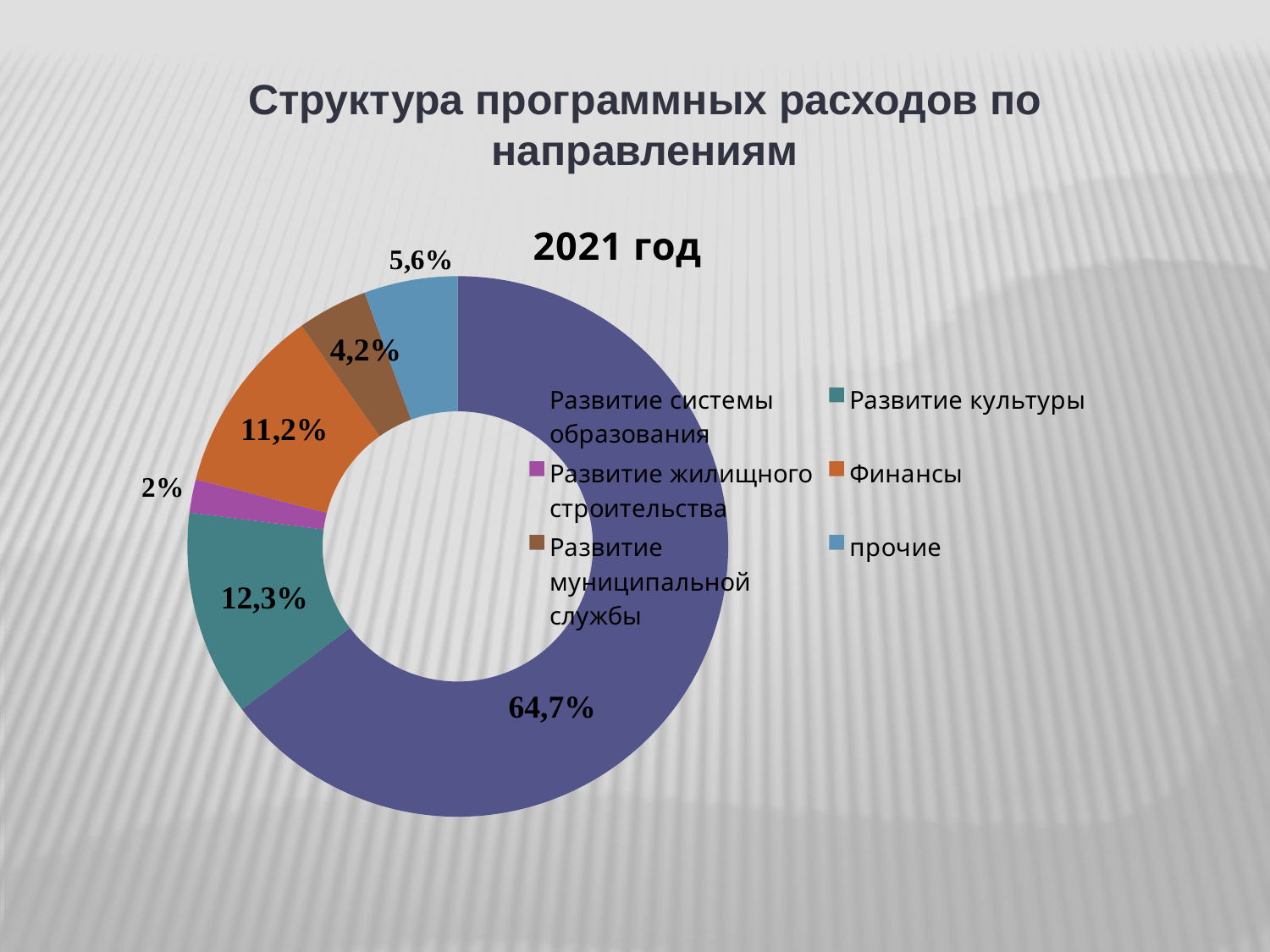
What kind of chart is shown on the slide? doughnut chart Which is larger, the share for прочие or the share for Развитие муниципальной службы? прочие Which category has the largest share of the chart? Развитие системы образования What percentage is shown for Финансы? 11,2% What is the value for Развитие муниципальной службы? 4,2% What is the difference in percentage points between Развитие культуры and Финансы? 1,1 What is the value shown for Развитие культуры? 12,3% What share is labelled for прочие? 5,6% What year is given in the chart title? 2021 год How many categories does the chart show? 6 What share of programme expenditure goes to Развитие системы образования? 64,7% Which category has the smallest share of the chart? Развитие жилищного строительства